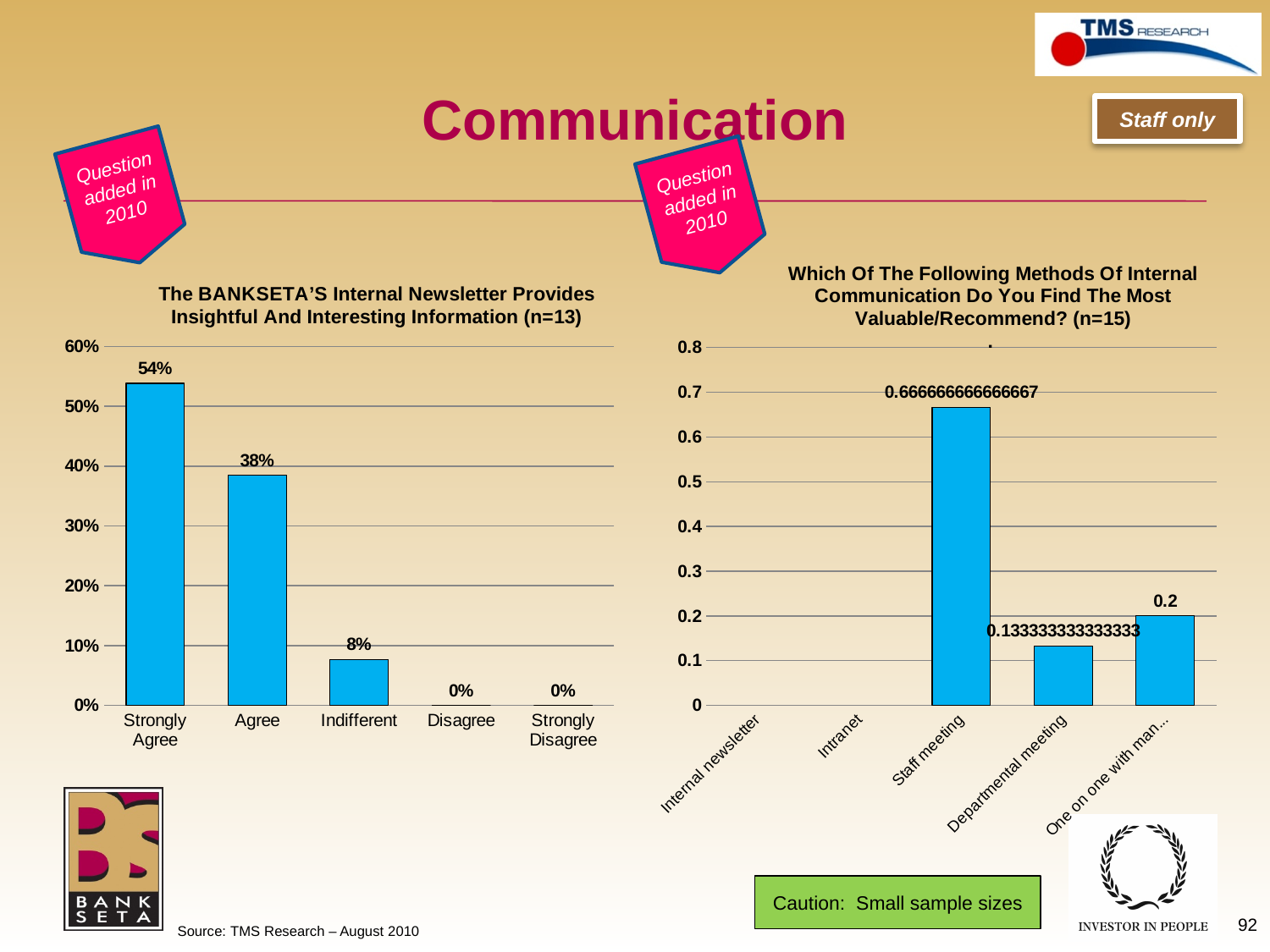
In the left chart about the internal newsletter, what is the difference between the Strongly Agree and Agree percentages? 16% In the left chart about the internal newsletter, how many response categories are shown on the x axis? 5 In the left chart about the internal newsletter, which category has the highest value? Strongly Agree In the left chart about the internal newsletter, what percentage of respondents chose Indifferent? 8% What type of chart is the right chart about methods of internal communication? Bar chart In the right chart about methods of internal communication, which category has the highest value? Staff meeting In the right chart about methods of internal communication, is the value for Staff meeting greater or less than 0.6? greater In the right chart about methods of internal communication, what is the value for Departmental meeting? 0.133333333333333 In the right chart about methods of internal communication, what is the value for Staff meeting? 0.666666666666667 In the right chart about methods of internal communication, which is larger: the value for Departmental meeting or the value for One on one with man...? One on one with man... In the left chart about the internal newsletter, what percentage of respondents chose Disagree? 0% In the left chart about the internal newsletter, what percentage of respondents chose Strongly Agree? 54%